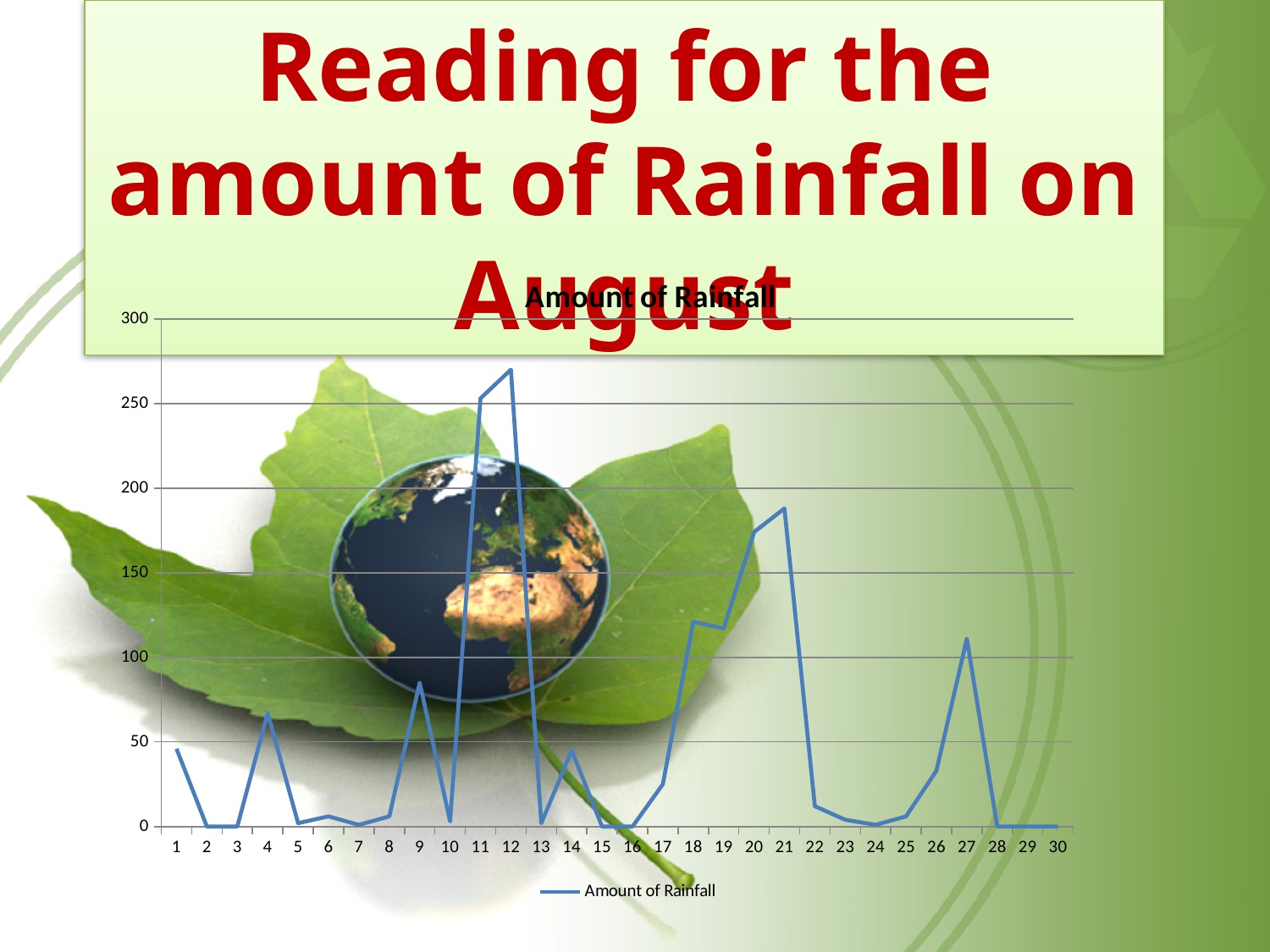
Is the value for day 27 greater or less than 100? greater What kind of chart is shown on the slide? line chart Do the values rise or fall from day 21 to day 24? fall Is the value for day 12 greater or less than 250? greater Is the value for day 9 greater or less than 100? less What is the title of the chart? Amount of Rainfall Which day has the larger value, day 9 or day 27? 27 How many series does the legend list? 1 On which day is the amount of rainfall highest? 12 How many days are plotted along the x axis? 30 Which day has the larger value, day 12 or day 21? 12